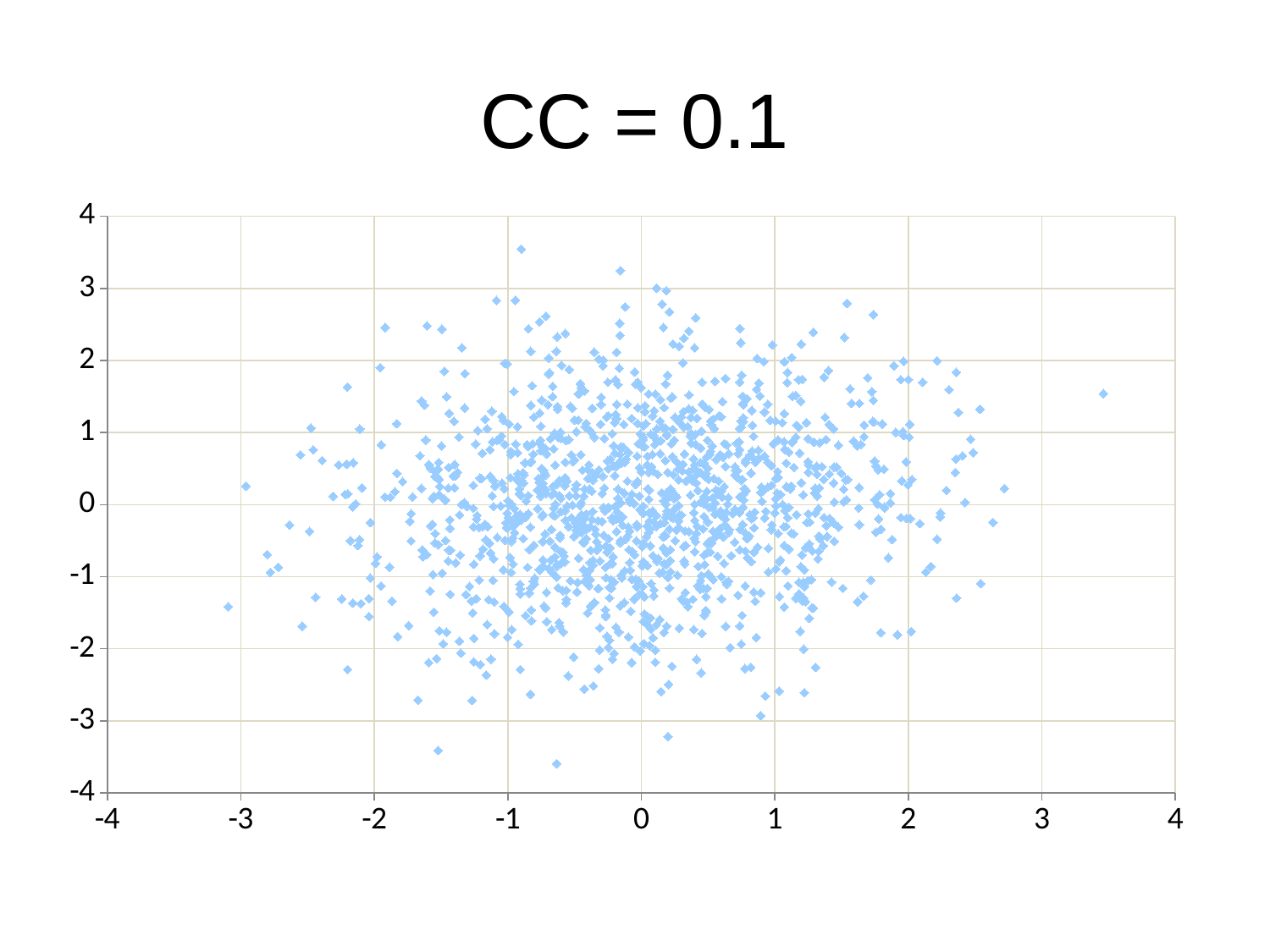
Is the y value of the lowest point greater or less than -3? less Is the y value of the rightmost point greater or less than 1? greater Is the x value of the leftmost point greater or less than -2? less What are the lowest and highest values shown on the x axis? -4 and 4 What is the title of the chart? CC = 0.1 What kind of chart is shown on the slide? scatter plot